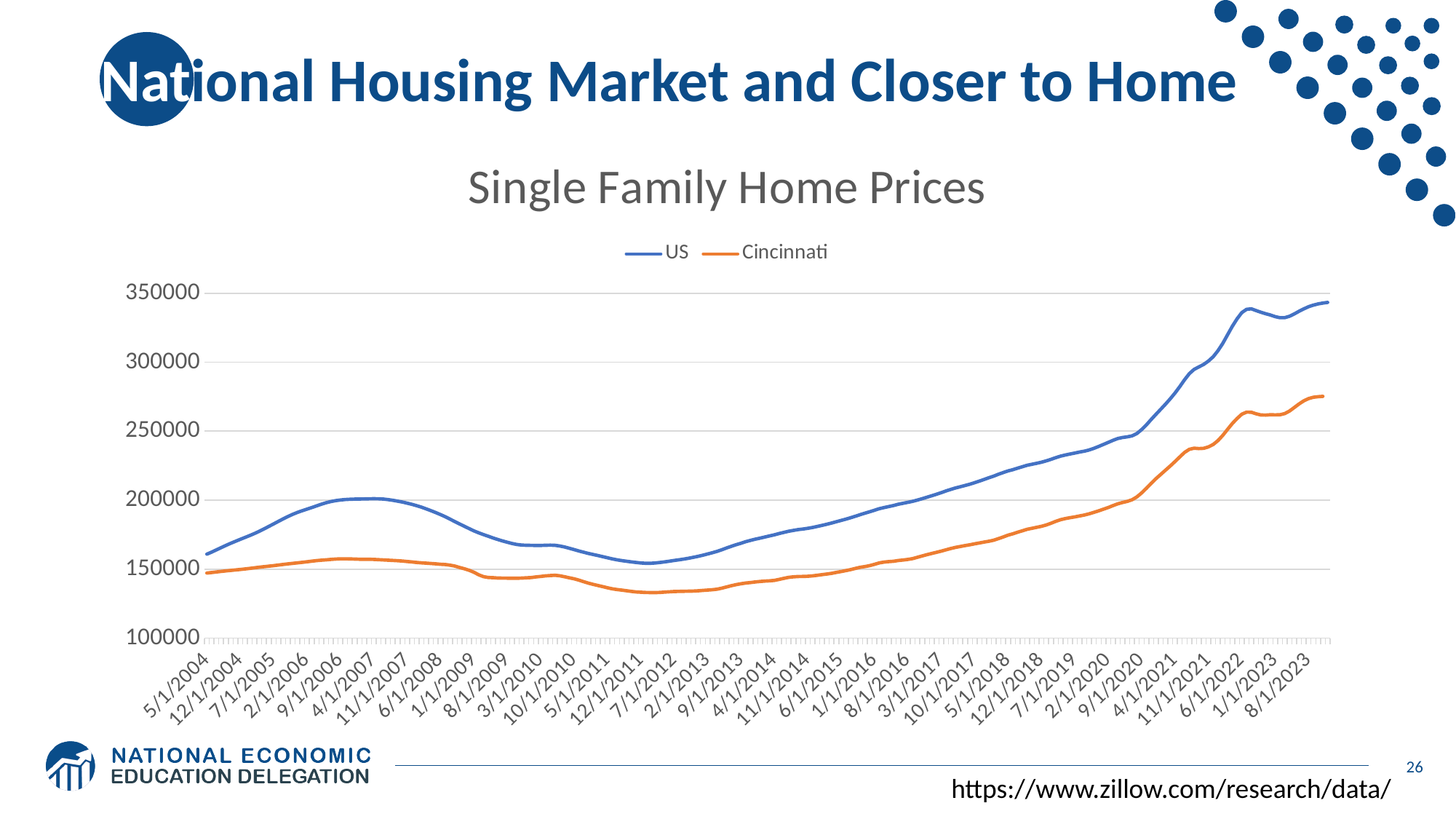
Is the value for Cincinnati at 8/1/2023 greater or less than 250000? greater What is the title of the chart? Single Family Home Prices How many series does the legend list? 2 Which series reaches the highest value on the chart? US Is the value for Cincinnati at 7/1/2012 greater or less than 150000? less Do the US values rise or fall between 7/1/2012 and 8/1/2023? rise At 8/1/2023, which series has the higher value, US or Cincinnati? US Is the value for US at 8/1/2023 greater or less than 350000? less What kind of chart is shown on the slide? line chart Which series is drawn in orange? Cincinnati